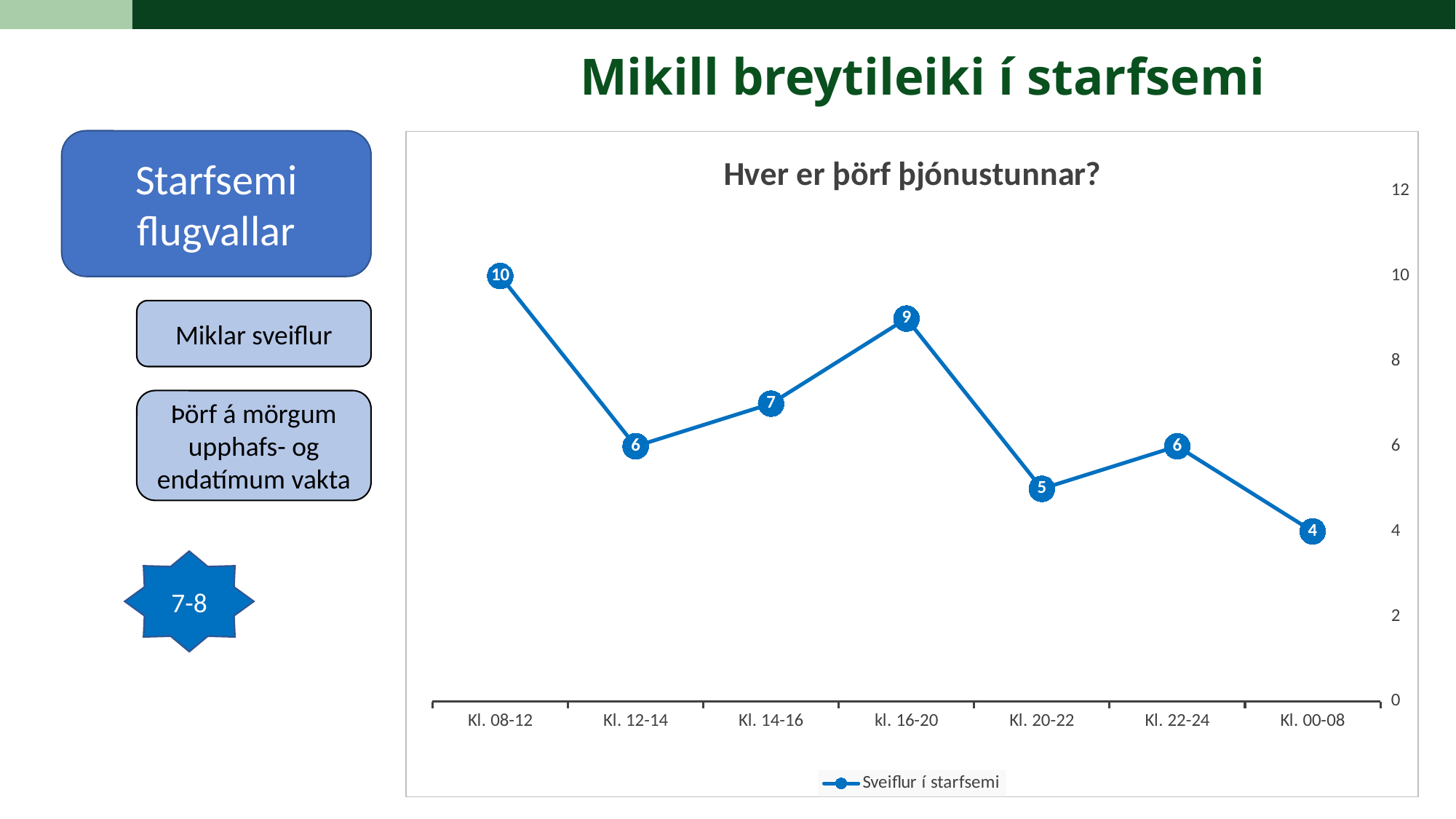
What kind of chart is shown? line chart How many series does the legend list? 1 What is the difference between the values for Kl. 08-12 and Kl. 12-14? 4 Is the value for kl. 16-20 greater or less than 8? greater Which time slot has the highest value? Kl. 08-12 What is the value for Kl. 00-08? 4 What is the value for Kl. 08-12? 10 What is the title of the chart? Hver er þörf þjónustunnar? Which is larger, the value for Kl. 14-16 or the value for Kl. 20-22? Kl. 14-16 How many time slots are plotted on the x axis? 7 What is the value for kl. 16-20? 9 Which time slot has the lowest value? Kl. 00-08